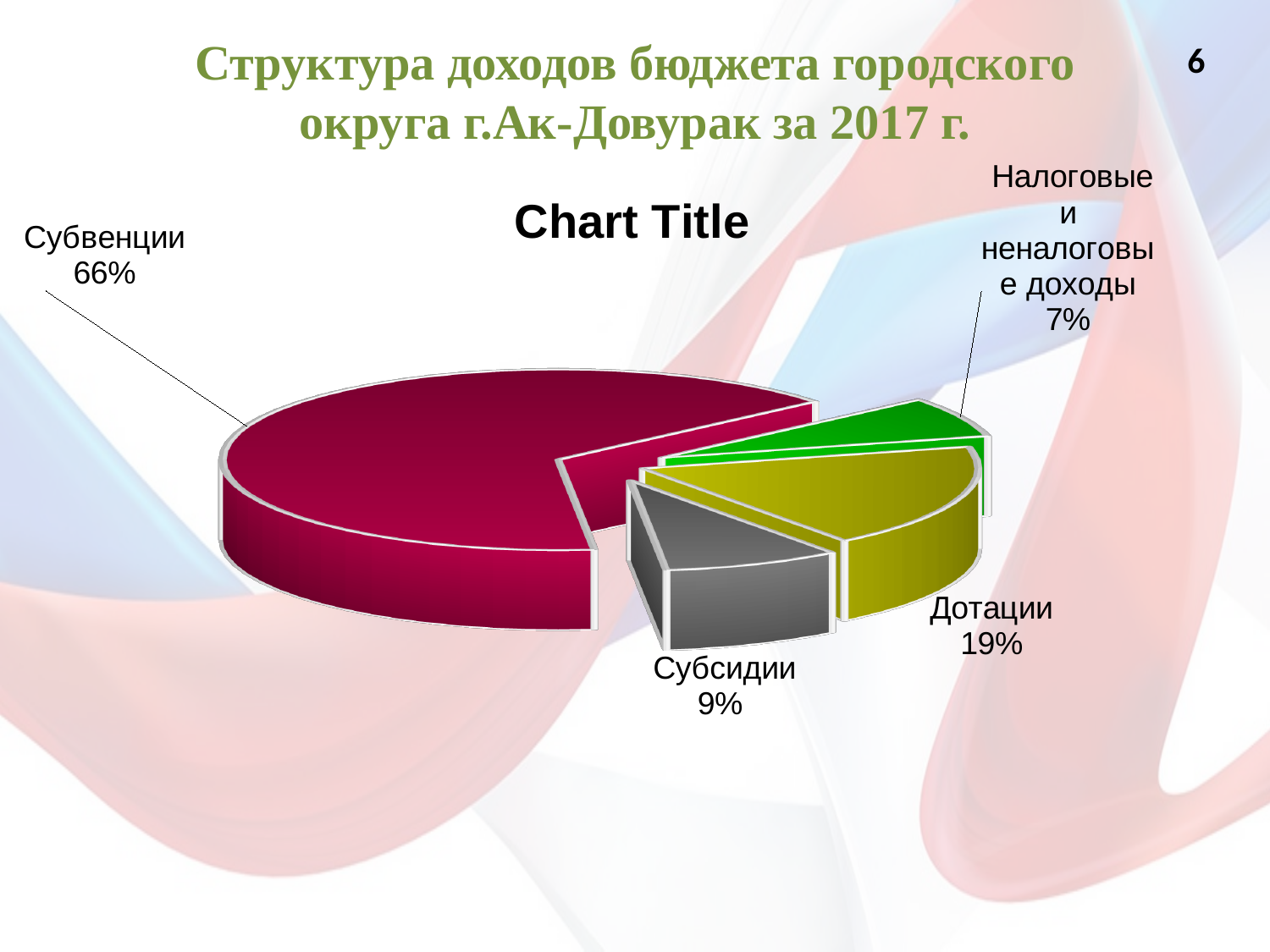
What is the difference in percentage points between Субсидии and Налоговые и неналоговые доходы? 2 What share of the pie does Налоговые и неналоговые доходы hold? 7% What kind of chart is shown on the slide? Pie chart Which category has the largest slice of the pie? Субвенции How many slices does the pie chart have? 4 What is the difference in percentage points between Субвенции and Дотации? 47 What share of the pie does Субвенции hold? 66% What share of the pie does Дотации hold? 19% What title is printed above the pie chart? Chart Title Which category has the smallest slice of the pie? Налоговые и неналоговые доходы Which is larger, the share for Субсидии or the share for Дотации? Дотации